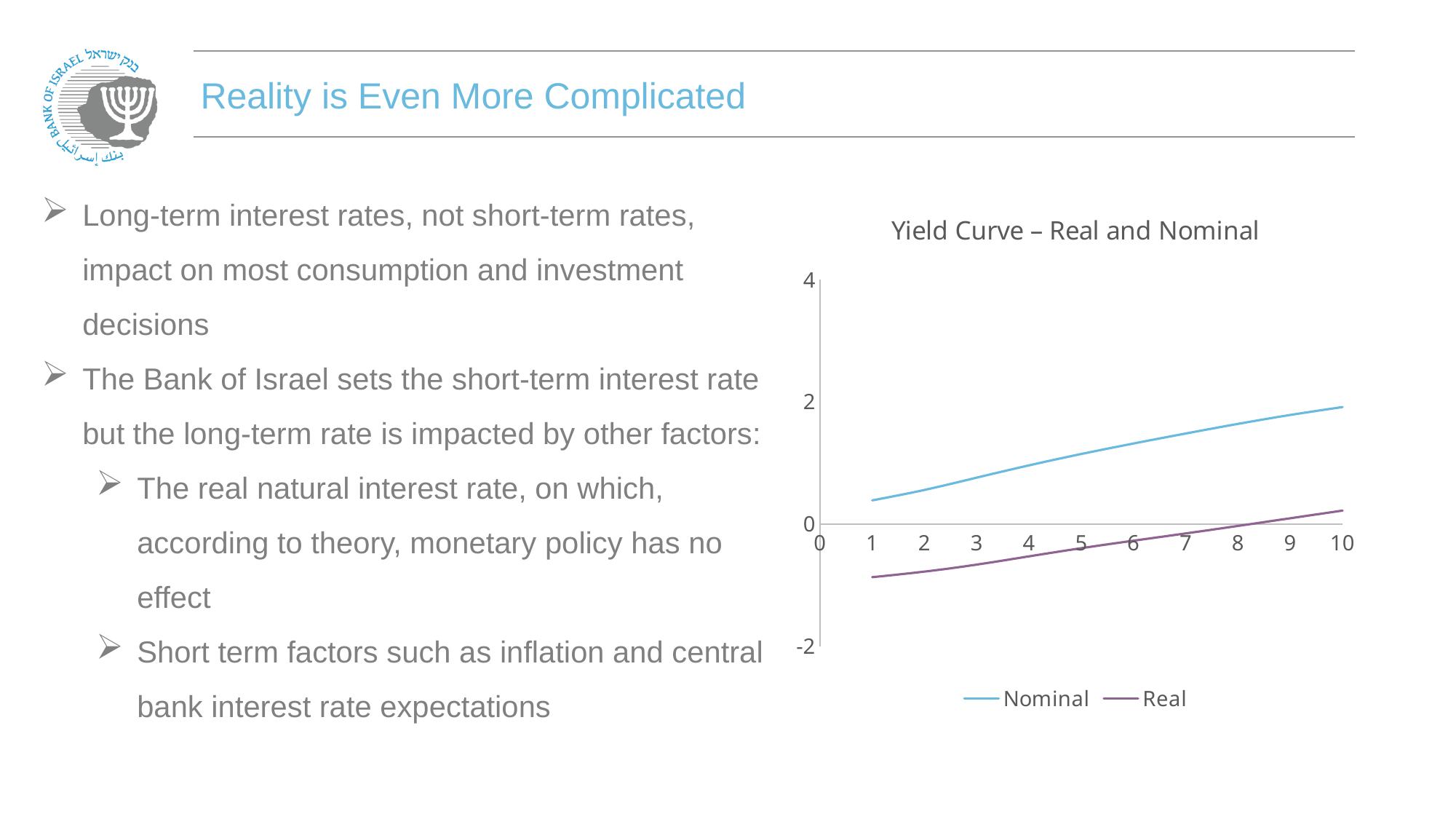
Which series is drawn in purple in the yield curve chart? Real Is the Real value at x = 1 greater or less than 0? less What kind of chart is shown on the slide? Line chart Does the Nominal yield curve rise or fall as the x axis increases from 1 to 10? Rises Is the Nominal value at x = 1 greater or less than 0? greater Which series lies higher across the whole chart, Nominal or Real? Nominal Does the Real yield curve rise or fall as the x axis increases from 1 to 10? Rises At x = 5, which series has the higher value, Nominal or Real? Nominal How many series does the legend of the yield curve chart list? 2 Is the Real value at x = 9 greater or less than 0? greater What is the title of the chart on the slide? Yield Curve – Real and Nominal